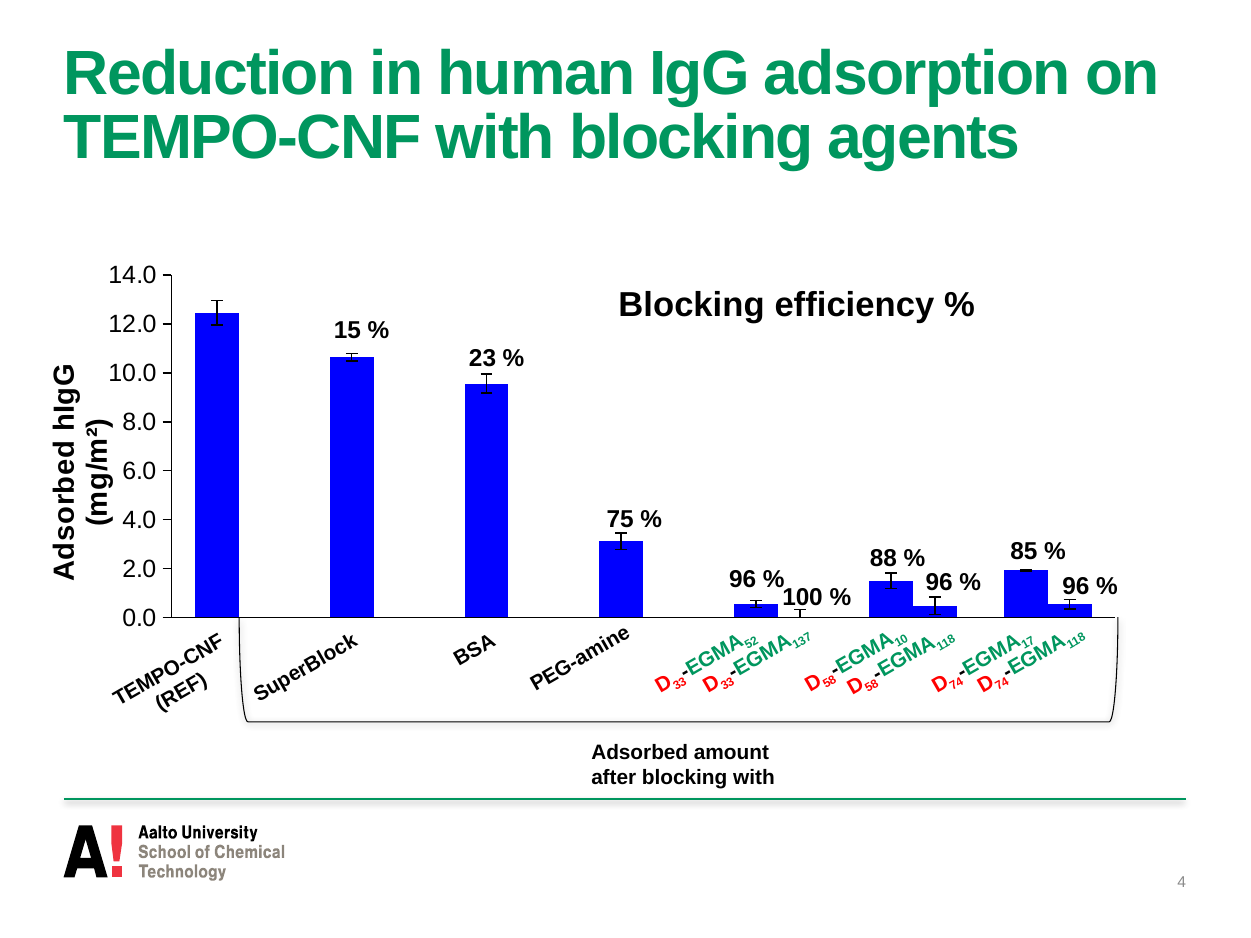
What blocking efficiency is labelled for SuperBlock? 15 % Which category has the lowest adsorbed hIgG value? D33-EGMA137 Is the adsorbed hIgG value for TEMPO-CNF (REF) greater or less than 12.0? greater What blocking efficiency is labelled for D33-EGMA137? 100 % Which category has the highest adsorbed hIgG value? TEMPO-CNF (REF) Is the adsorbed hIgG value for PEG-amine greater or less than 4.0? less What blocking efficiency is labelled for D58-EGMA10? 88 % What blocking efficiency is labelled for PEG-amine? 75 % What kind of chart is shown on the slide? bar chart By how many percentage points does the blocking efficiency of BSA exceed that of SuperBlock? 8 How many bars (categories) are plotted in the chart? 10 Which has a larger adsorbed hIgG value, SuperBlock or BSA? SuperBlock